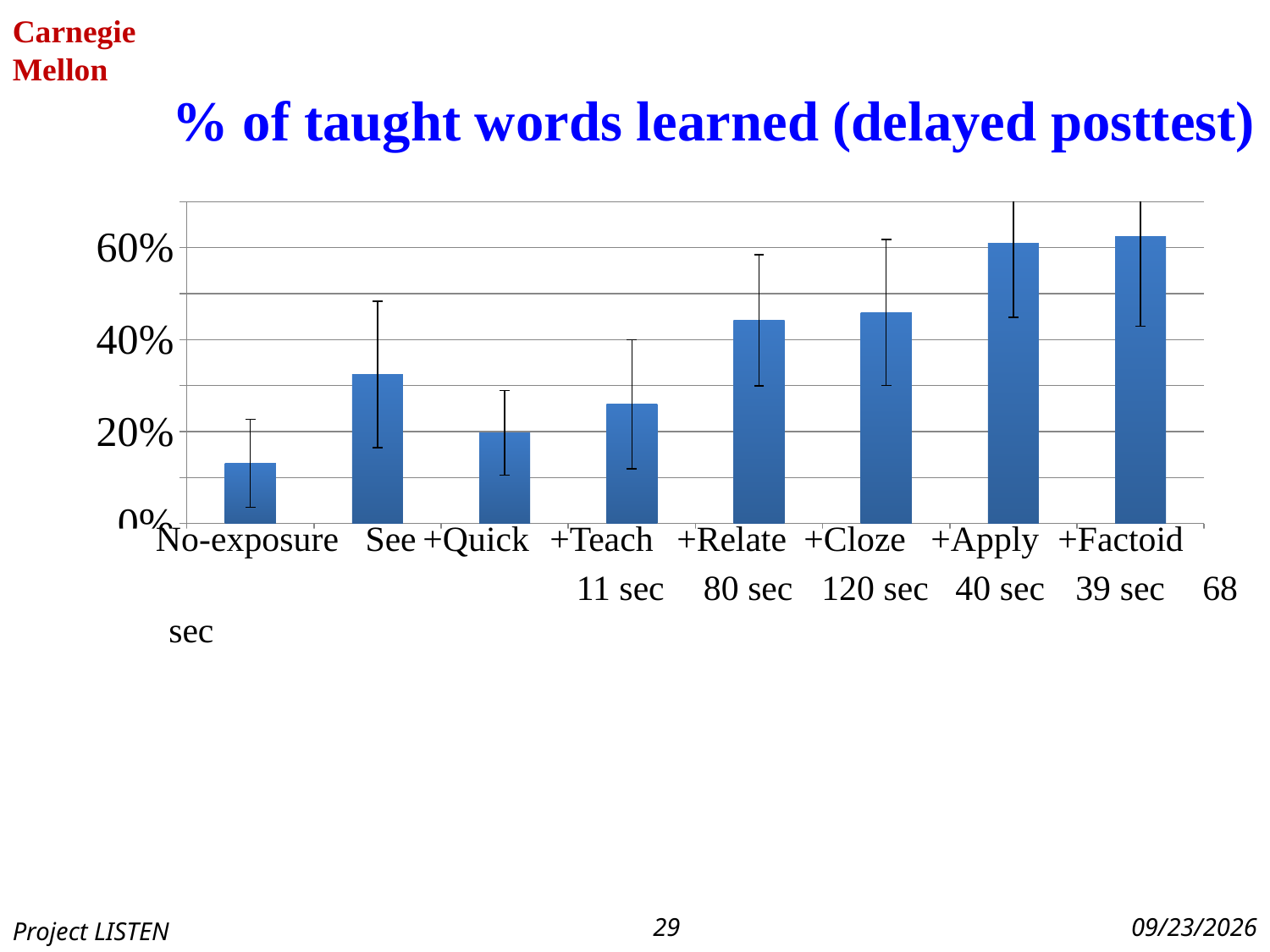
Which is larger, the value for +Teach or the value for +Relate? +Relate What kind of chart is shown on the slide? bar chart Is the value for +Apply greater or less than 40%? greater Is the value for No-exposure greater or less than 20%? less Which is larger, the value for +Apply or the value for +Cloze? +Apply Which category has the lowest % of taught words learned? No-exposure Is the value for See greater or less than 20%? greater What is the title of the chart? % of taught words learned (delayed posttest) How many categories (bars) does the chart show? 8 Which is larger, the value for See or the value for +Quick? See